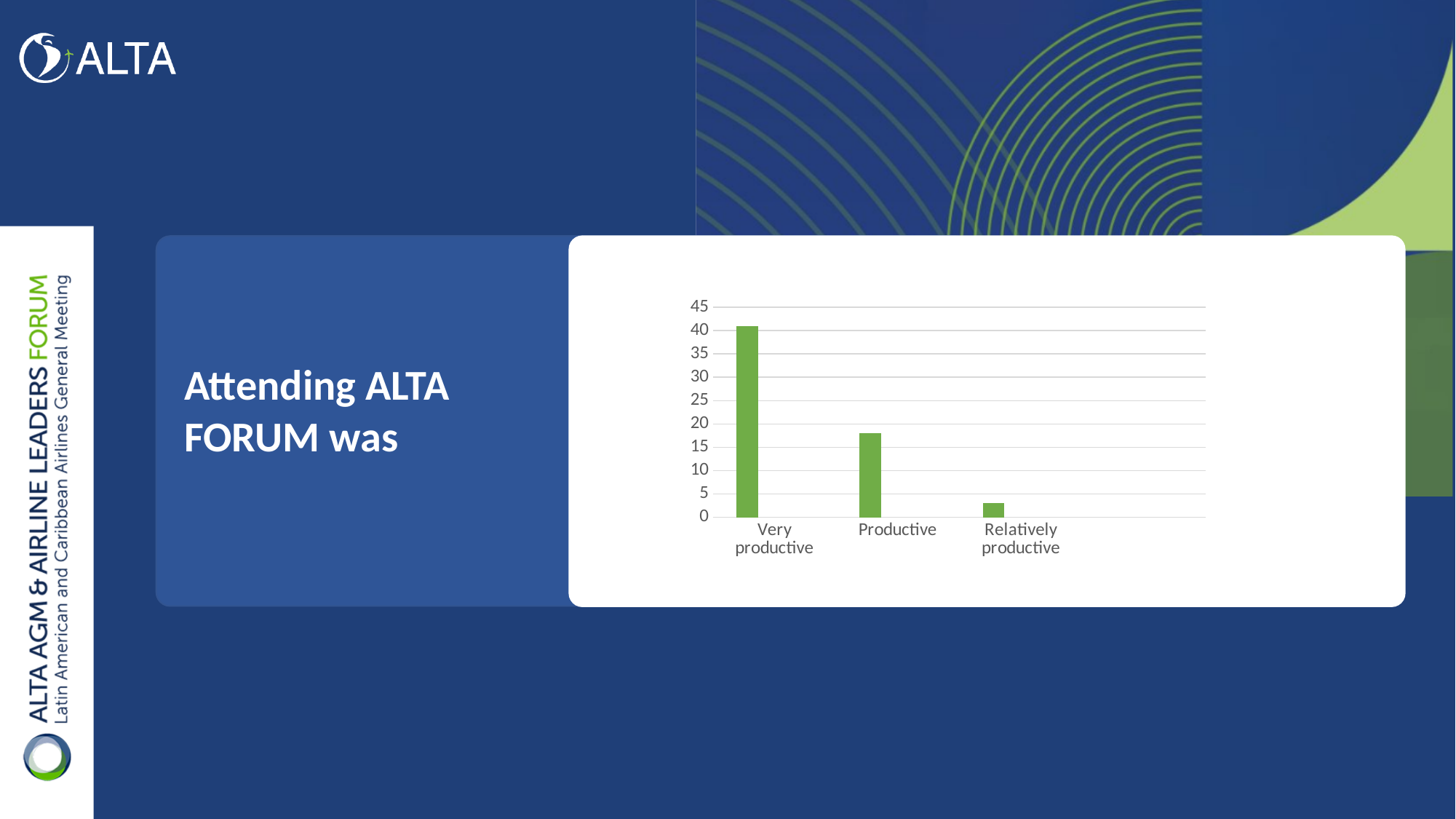
Which category has the lowest value in the chart? Relatively productive Which is larger, the value for Productive or the value for Relatively productive? Productive What is the highest value shown on the chart's vertical axis? 45 How many categories are shown on the x axis of the chart? 3 Which is larger, the value for Very productive or the value for Productive? Very productive Which category has the highest value in the chart? Very productive What kind of chart is shown on the slide? bar chart Is the value for Very productive greater or less than 35? greater Is the value for Productive greater or less than 25? less Do the values rise or fall moving from left to right along the x axis? fall Is the value for Relatively productive greater or less than 5? less